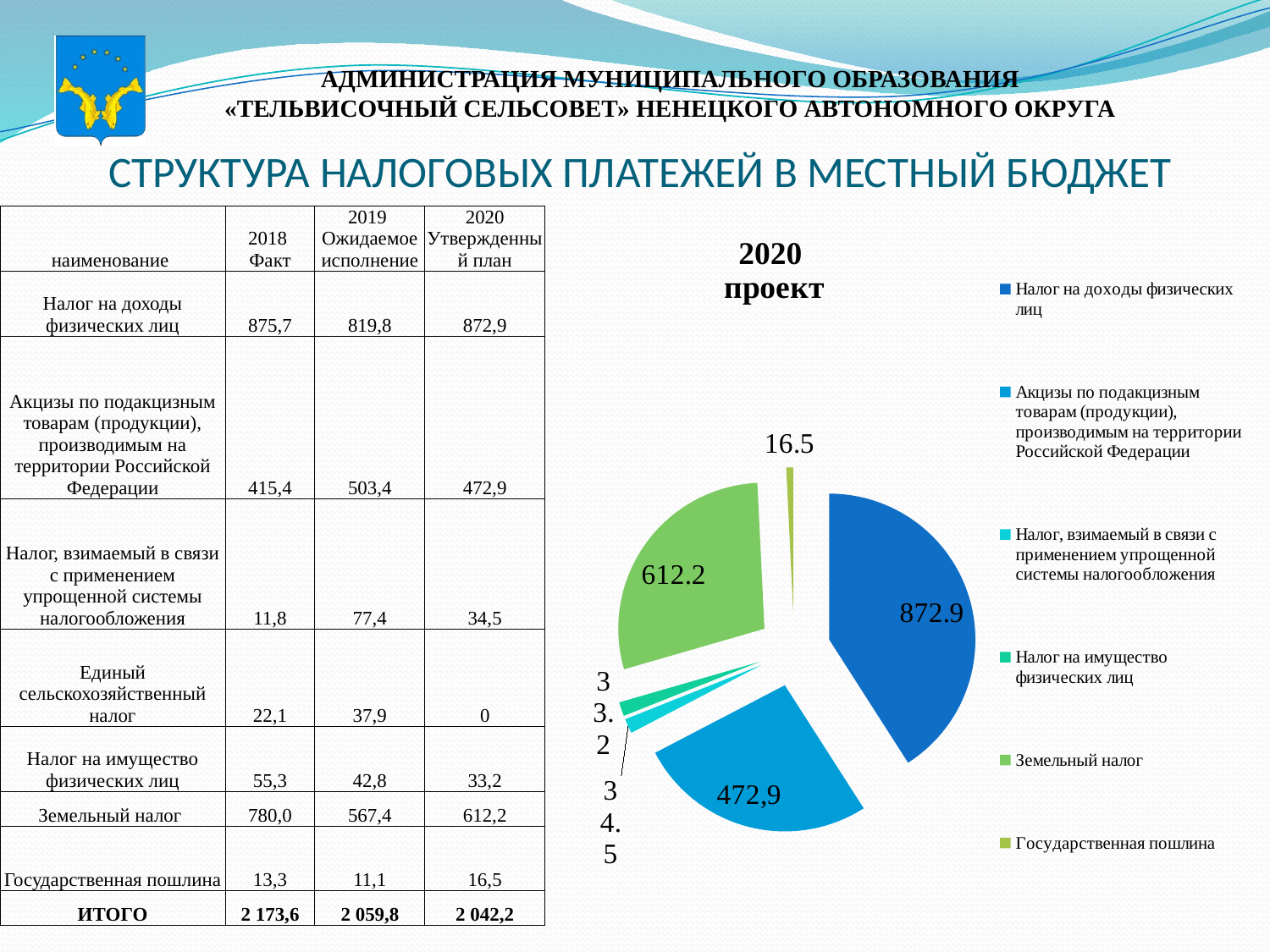
How many slices does the pie chart have? 6 What value is shown on the pie chart for Земельный налог? 612.2 In the pie chart, what is the difference between the value for Налог на доходы физических лиц and the value for Земельный налог? 260.7 What colour is the largest slice of the pie chart? blue What value is shown on the pie chart for Государственная пошлина? 16.5 What kind of chart is shown on the slide? pie chart What value is shown on the pie chart for Налог на доходы физических лиц? 872.9 What is the title of the pie chart? 2020 проект Which category has the largest slice in the pie chart? Налог на доходы физических лиц In the pie chart, which is larger: Земельный налог or Акцизы по подакцизным товарам? Земельный налог How many entries does the legend of the pie chart list? 6 What value is shown on the pie chart for Акцизы по подакцизным товарам (продукции), производимым на территории Российской Федерации? 472,9